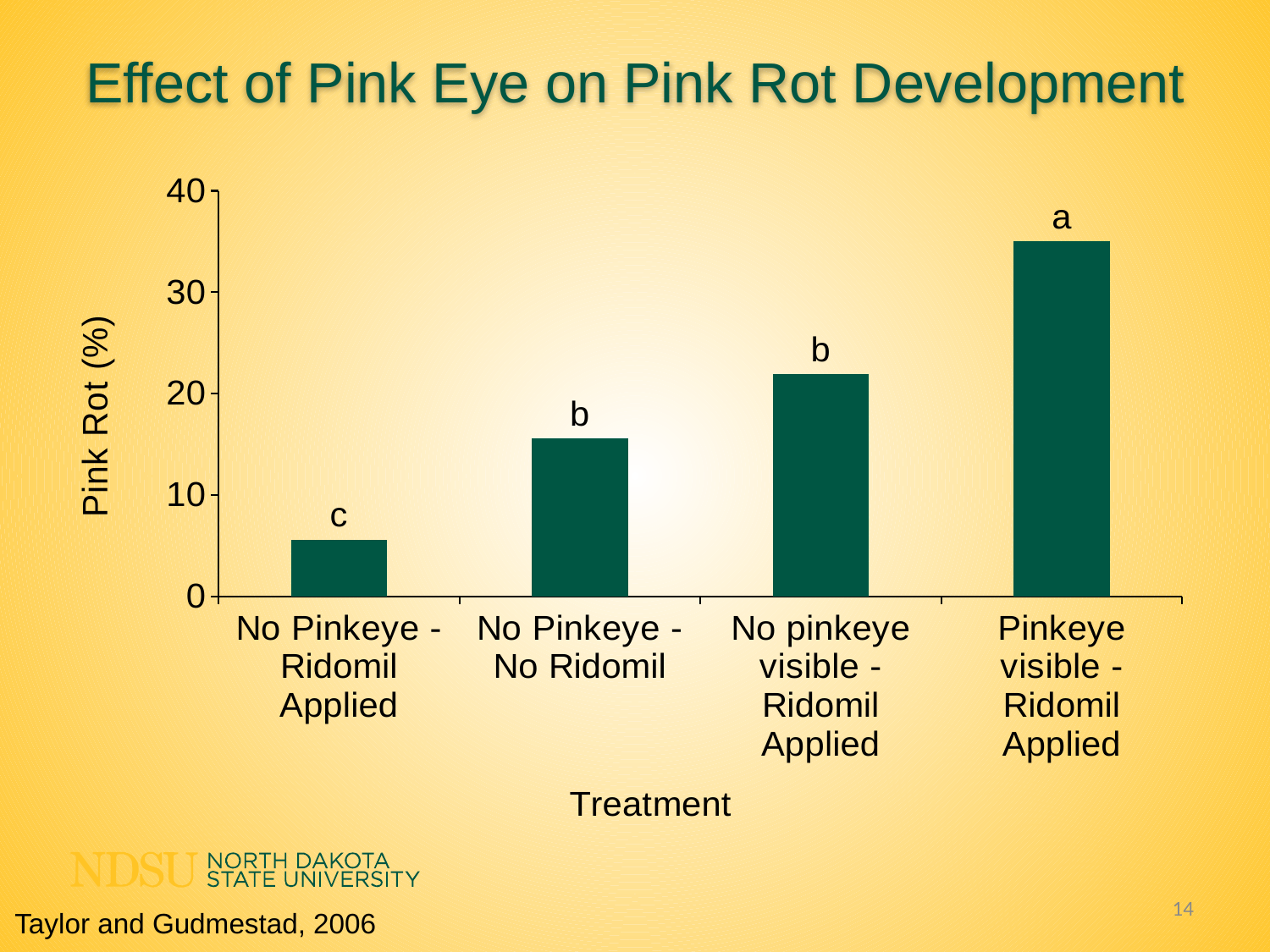
Is the Pink Rot (%) for Pinkeye visible - Ridomil Applied greater or less than 30? greater Which treatment has the lowest Pink Rot (%)? No Pinkeye - Ridomil Applied Which has a higher Pink Rot (%): No pinkeye visible - Ridomil Applied or No Pinkeye - No Ridomil? No pinkeye visible - Ridomil Applied What letter is printed above the bar for Pinkeye visible - Ridomil Applied? a Do the Pink Rot (%) values rise or fall moving left to right across the treatments? rise Is the Pink Rot (%) for No Pinkeye - Ridomil Applied greater or less than 10? less What kind of chart is shown on the slide? bar chart What is the title of the chart? Effect of Pink Eye on Pink Rot Development Is the Pink Rot (%) for No Pinkeye - No Ridomil greater or less than 10? greater How many treatment categories are shown on the x axis? 4 Which treatment has the highest Pink Rot (%)? Pinkeye visible - Ridomil Applied